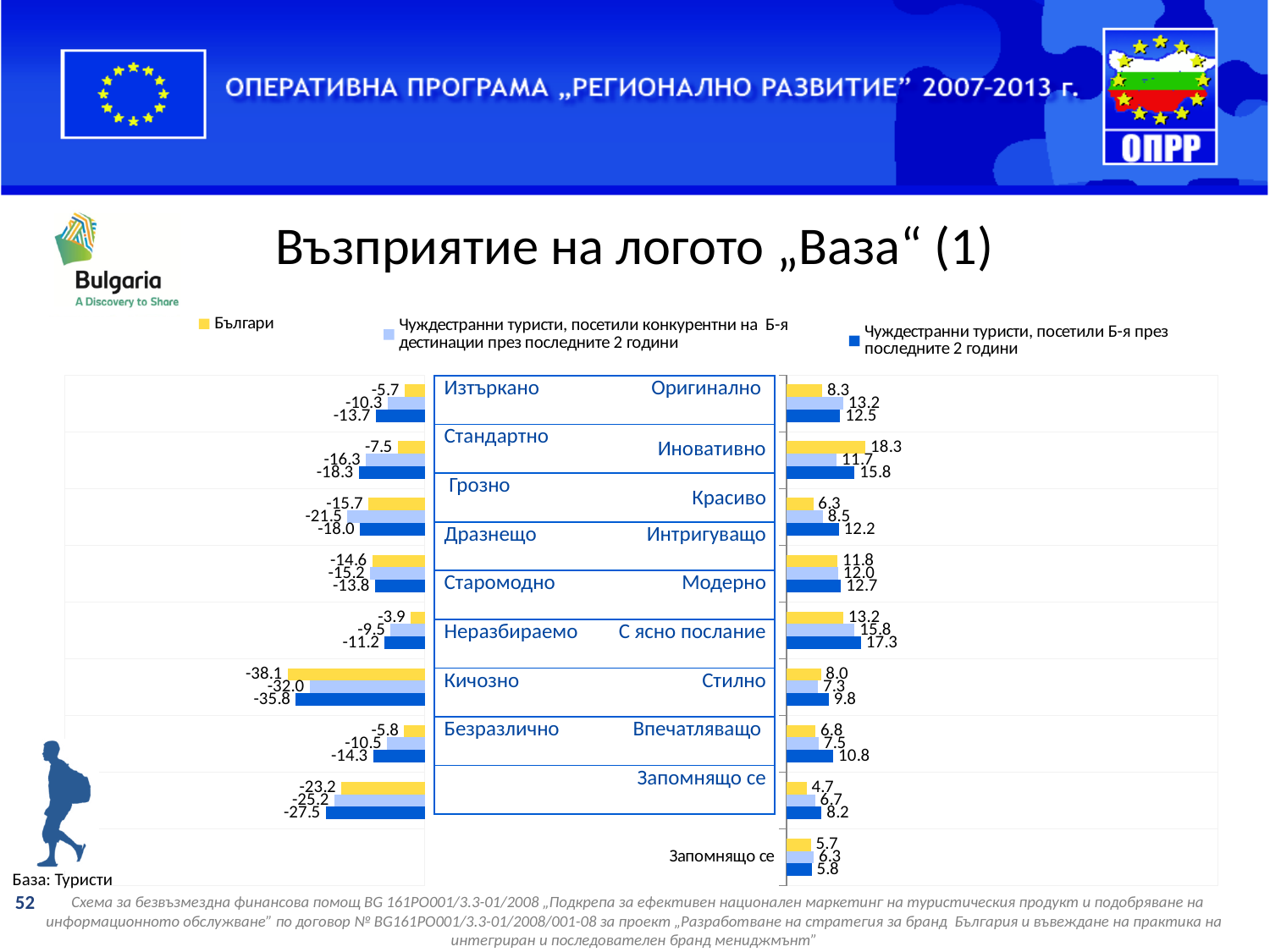
How many series does the legend list? 3 In the left chart, what is the value for Българи in the Изтъркано row? -5.7 What kind of chart is used on this slide? bar chart In the right chart, what is the value for Българи in the Оригинално row? 8.3 In the right chart, Запомнящо се row, which is larger: the value for Българи or the value for Чуждестранни туристи, посетили конкурентни на Б-я дестинации? Чуждестранни туристи, посетили конкурентни на Б-я дестинации In the right chart, what is the value for Чуждестранни туристи, посетили Б-я през последните 2 години in the Запомнящо се row? 5.8 In the left chart, what is the lowest (most negative) value shown? -38.1 What colour represents the Българи series in the legend? yellow In the right chart, Оригинално row, what is the difference between the value for Чуждестранни туристи, посетили конкурентни на Б-я дестинации (13.2) and the value for Българи (8.3)? 4.9 In the right chart, what is the highest value shown for Българи? 18.3 In the left chart, what is the value for Чуждестранни туристи, посетили Б-я през последните 2 години in the Изтъркано row? -13.7 How many category rows does the right chart have? 9